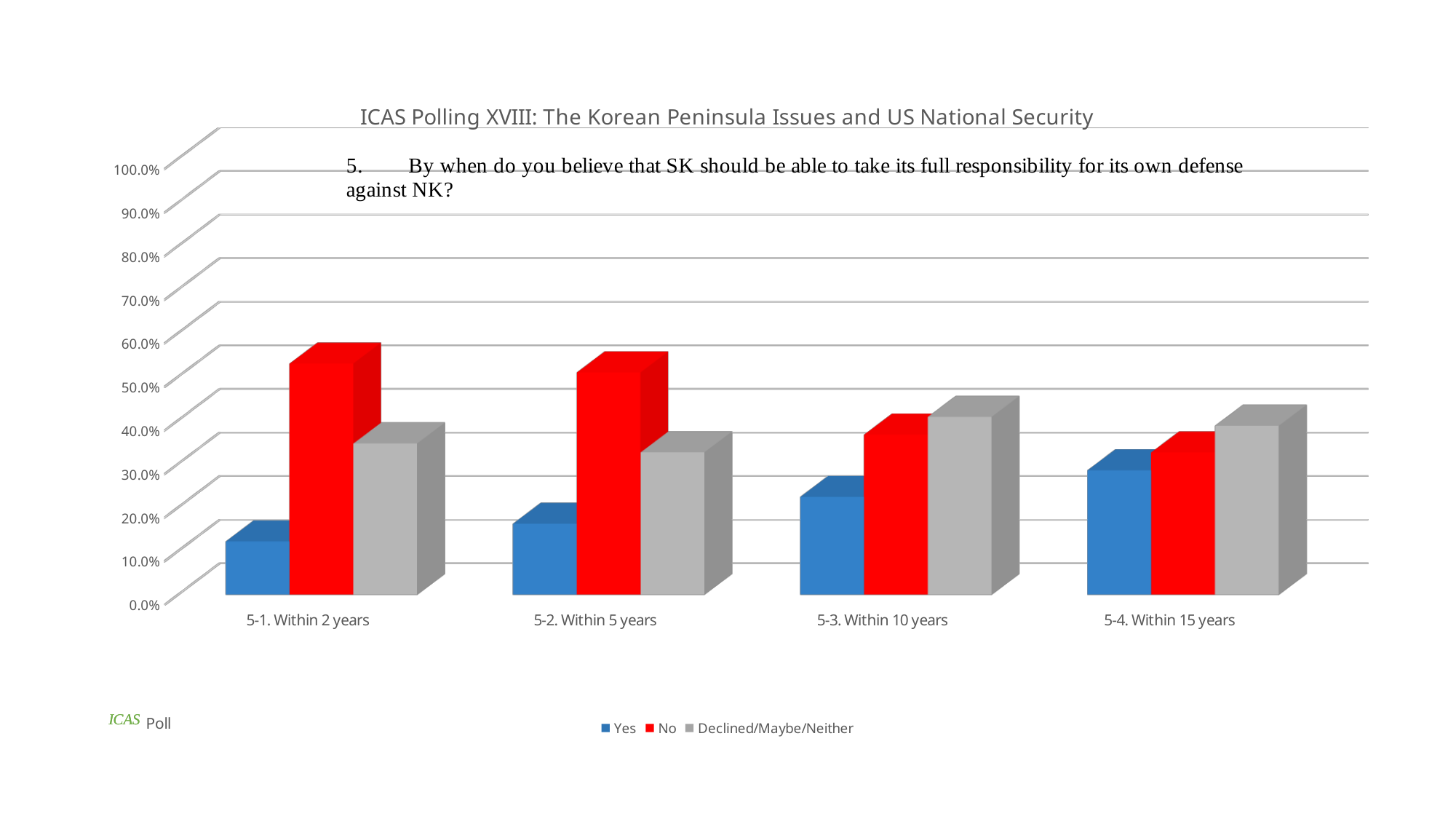
How many series does the legend list? 3 Which category has the lowest value for the Yes series? 5-1. Within 2 years Is the value for Yes in 5-1. Within 2 years greater or less than 20%? less Is the value for Yes in 5-3. Within 10 years greater or less than 30%? less Do the values for the Yes series rise or fall from 5-1. Within 2 years to 5-4. Within 15 years? rise How many categories are shown on the x axis? 4 Which category has the highest value for the No series? 5-1. Within 2 years Is the value for Declined/Maybe/Neither in 5-3. Within 10 years greater or less than 30%? greater In 5-2. Within 5 years, which is larger: Yes or No? No What kind of chart is shown on the slide? bar chart Which series is shown in red? No